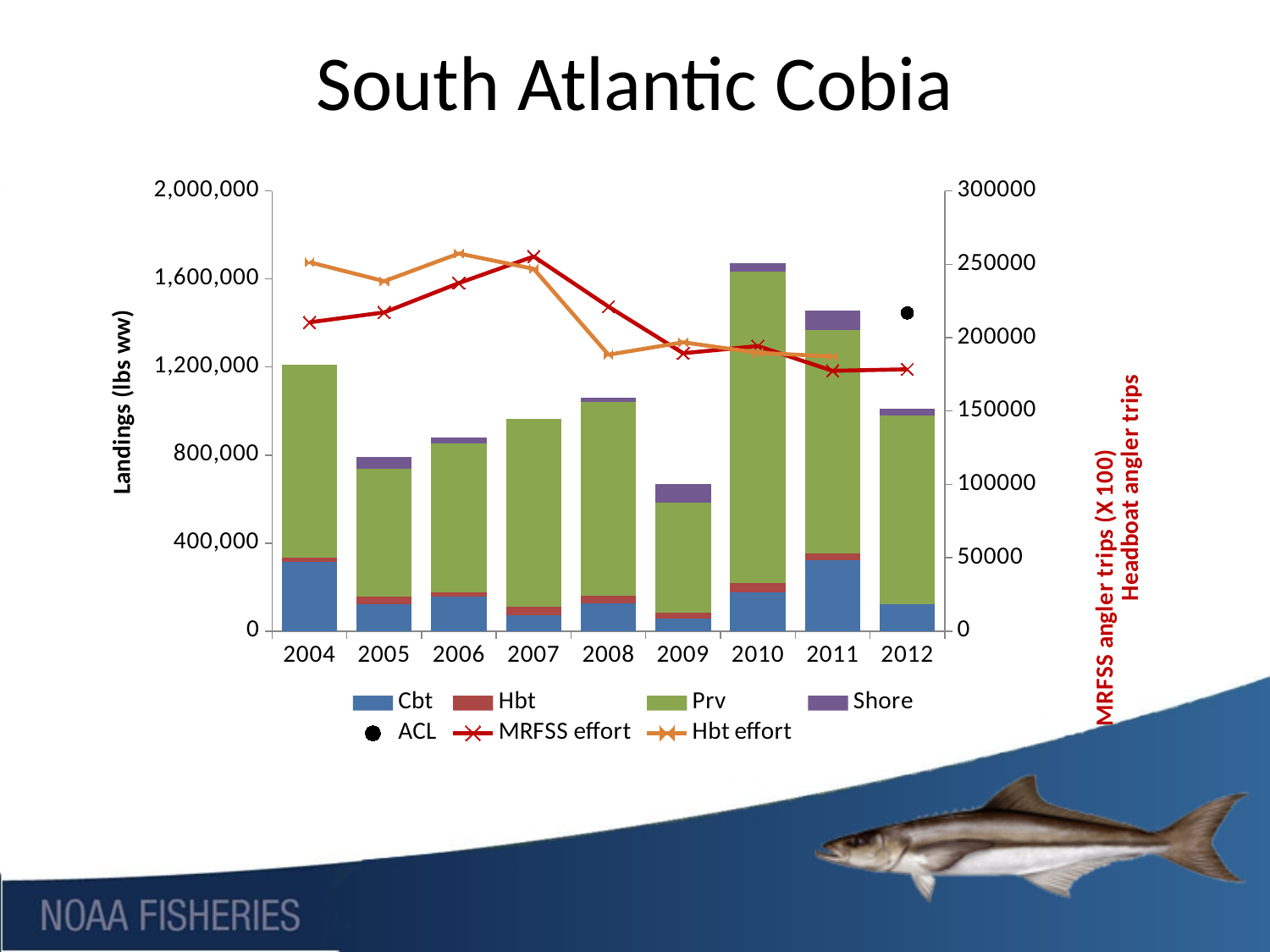
How many series does the legend list? 7 Which year has a larger total landings bar, 2004 or 2005? 2004 Is the MRFSS effort value for 2011 greater or less than 200000? less Which year has the highest total landings bar? 2010 What kind of chart is shown on the slide? stacked bar chart with line series What is the title of the left vertical axis? Landings (lbs ww) Is the Hbt effort value for 2007 greater or less than 200000? greater Which year has the lowest total landings bar? 2009 Is the total landings bar for 2009 greater or less than 800,000? less In which year does the MRFSS effort line reach its highest point? 2007 How many years are shown on the x axis? 9